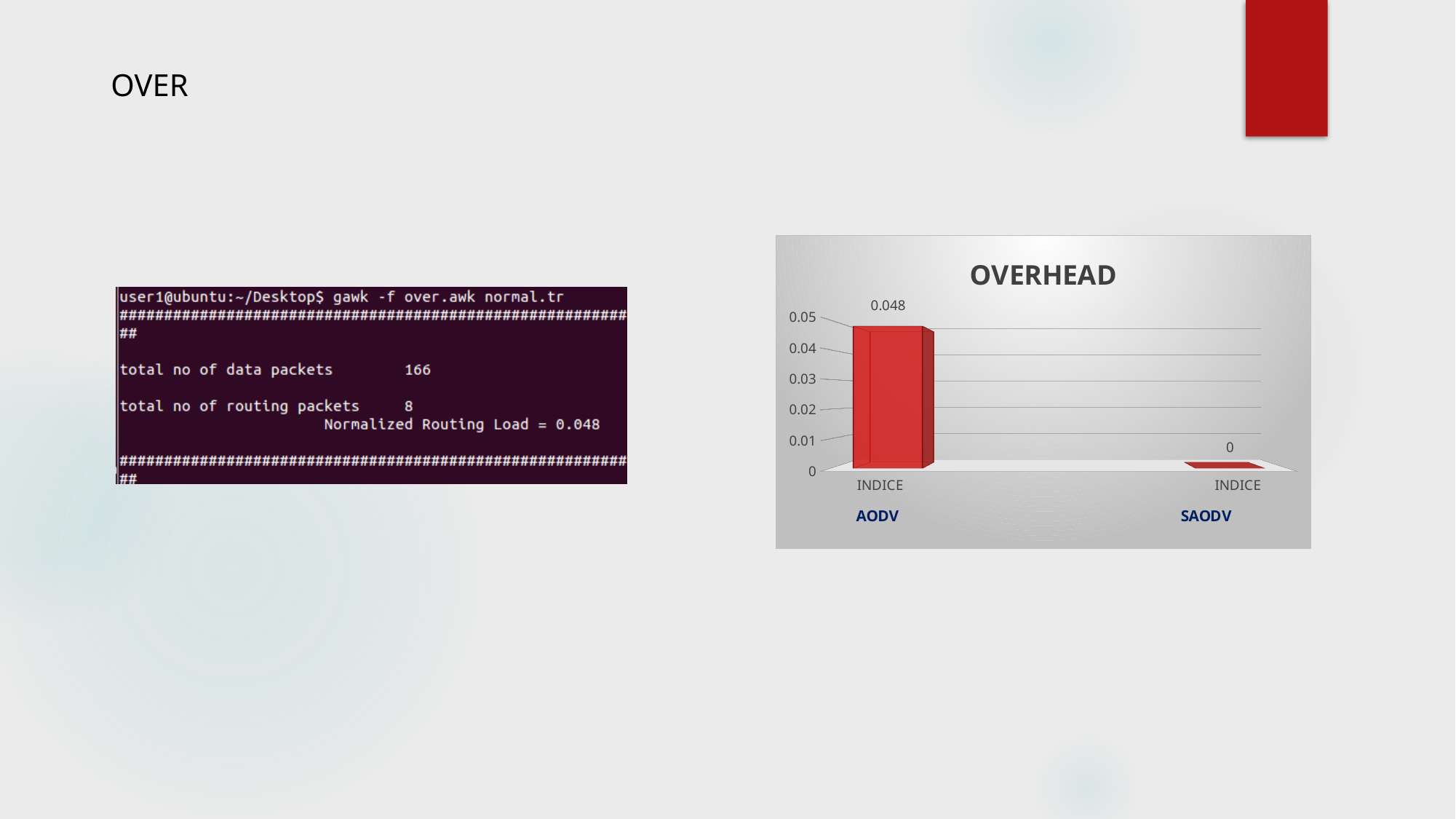
Which protocol has the highest overhead value in the chart? AODV What is the difference between the overhead values of AODV and SAODV? 0.048 What is the title of the chart? OVERHEAD What is the overhead value shown for SAODV? 0 How many bars are plotted in the chart? 2 Is the overhead value for AODV greater or less than 0.04? greater Which protocol has the higher overhead value, AODV or SAODV? AODV What type of chart is shown on the slide? bar chart What is the highest value shown on the vertical axis of the chart? 0.05 Which protocol has the lowest overhead value in the chart? SAODV Do the values fall or rise going from AODV to SAODV along the x axis? fall What is the overhead value shown for AODV? 0.048